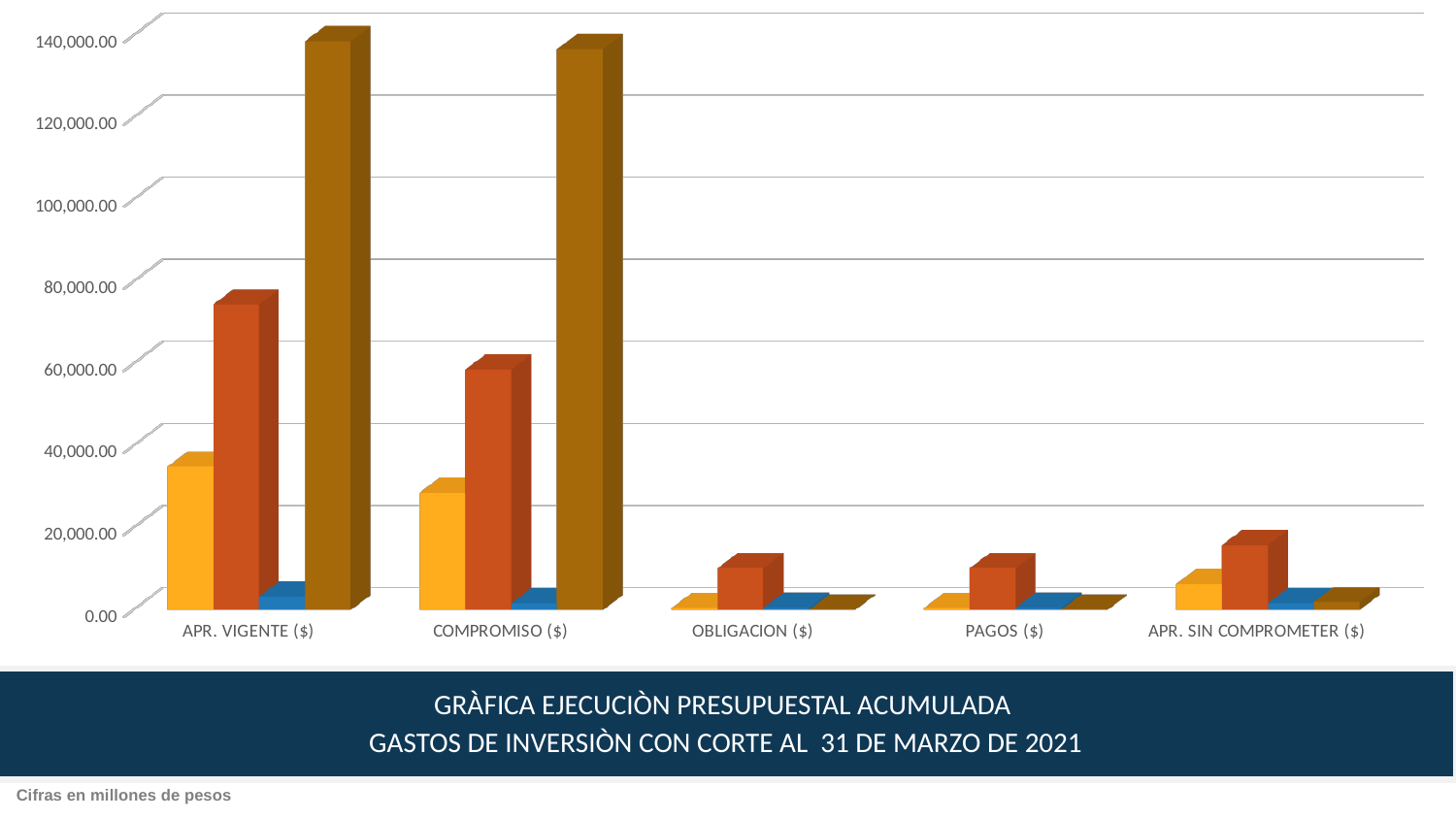
Is the value of the brown bar for APR. VIGENTE ($) greater or less than 120,000.00? greater Is the value of the orange bar for COMPROMISO ($) greater or less than 80,000.00? less Which category contains the tallest bar in the chart? APR. VIGENTE ($) How many categories are shown along the x axis? 5 According to the note below the chart, in what units are the figures expressed? Cifras en millones de pesos Is the value of the yellow bar for APR. VIGENTE ($) greater or less than 20,000.00? greater How many bars are plotted for each category? 4 What kind of chart is shown on the slide? bar chart Which is larger, the orange bar for APR. VIGENTE ($) or the orange bar for COMPROMISO ($)? APR. VIGENTE ($)